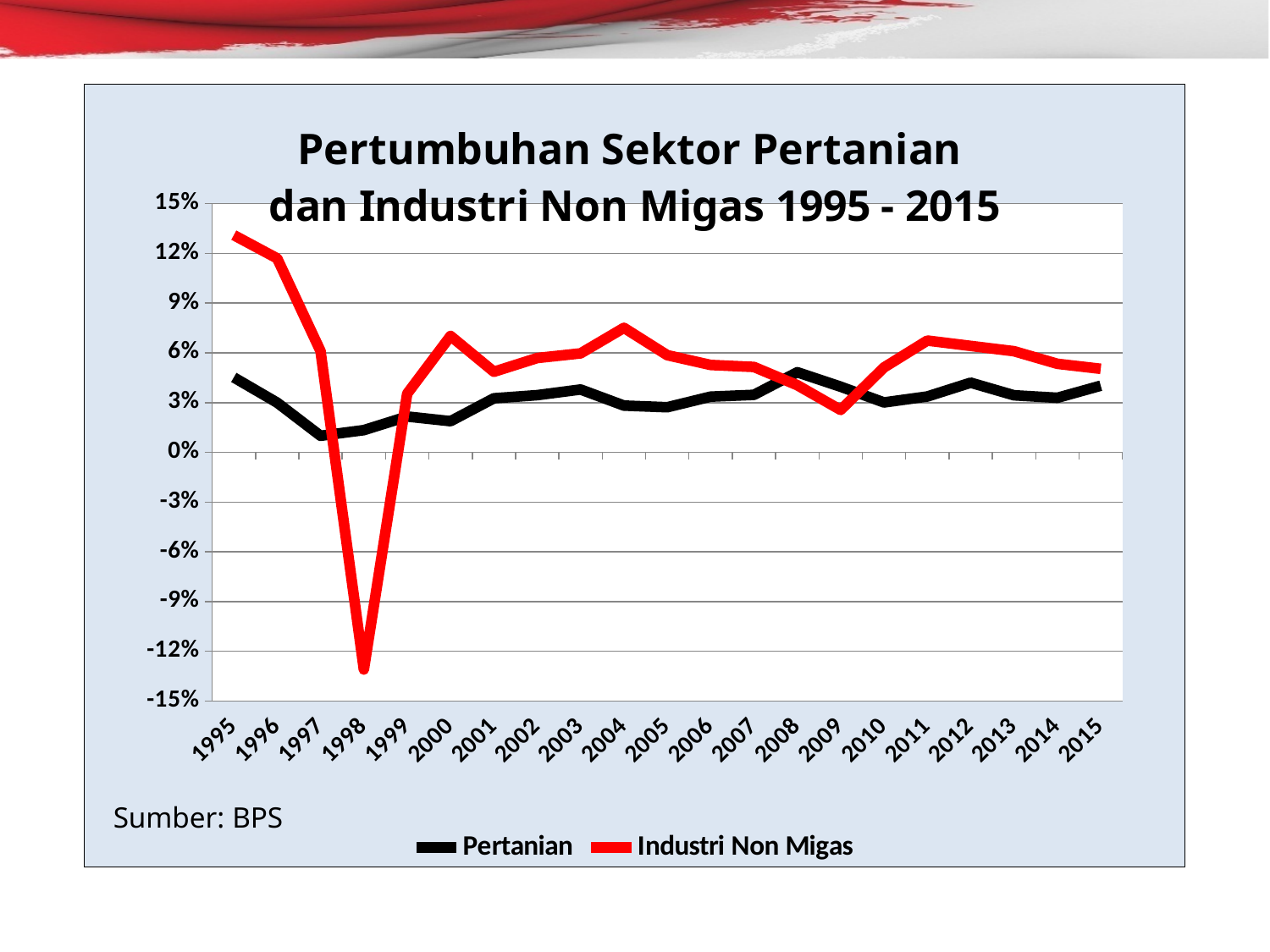
How many series does the legend list? 2 What kind of chart is shown on the slide? line chart In which year is the Industri Non Migas value highest? 1995 In 1996, which series has the higher value, Pertanian or Industri Non Migas? Industri Non Migas In which year is the Industri Non Migas value lowest? 1998 Is the Industri Non Migas value for 1998 greater or less than -9%? less What source is cited below the chart? BPS In 2009, which series has the higher value, Pertanian or Industri Non Migas? Pertanian Is the Industri Non Migas value for 1995 greater or less than 12%? greater Is the Pertanian value for 1997 greater or less than 3%? less Does the Industri Non Migas line rise or fall from 1995 to 1998? fall How many years are plotted along the x axis? 21